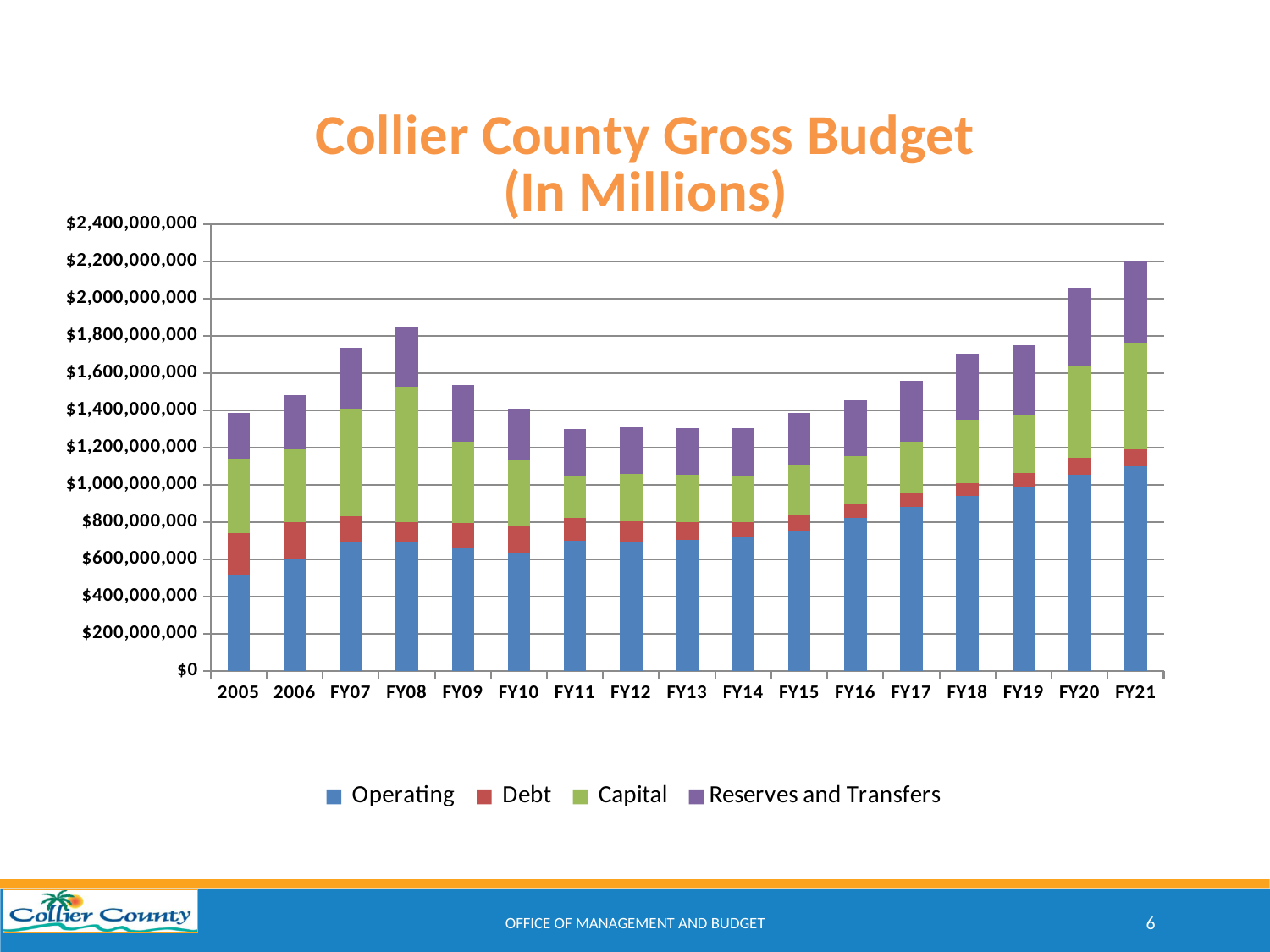
Is the Operating value for FY21 greater or less than $1,000,000,000? greater Do the total gross budget values rise or fall from FY14 to FY21? rise Is the total gross budget for FY11 greater or less than $1,400,000,000? less Is the total gross budget for FY07 greater or less than $1,800,000,000? less Which has the larger total gross budget, FY08 or FY07? FY08 Which year has the highest total gross budget? FY21 What is the title of the chart? Collier County Gross Budget (In Millions) What kind of chart is shown on the slide? Stacked bar chart How many series does the legend list? 4 How many fiscal years (categories) are shown on the x axis? 17